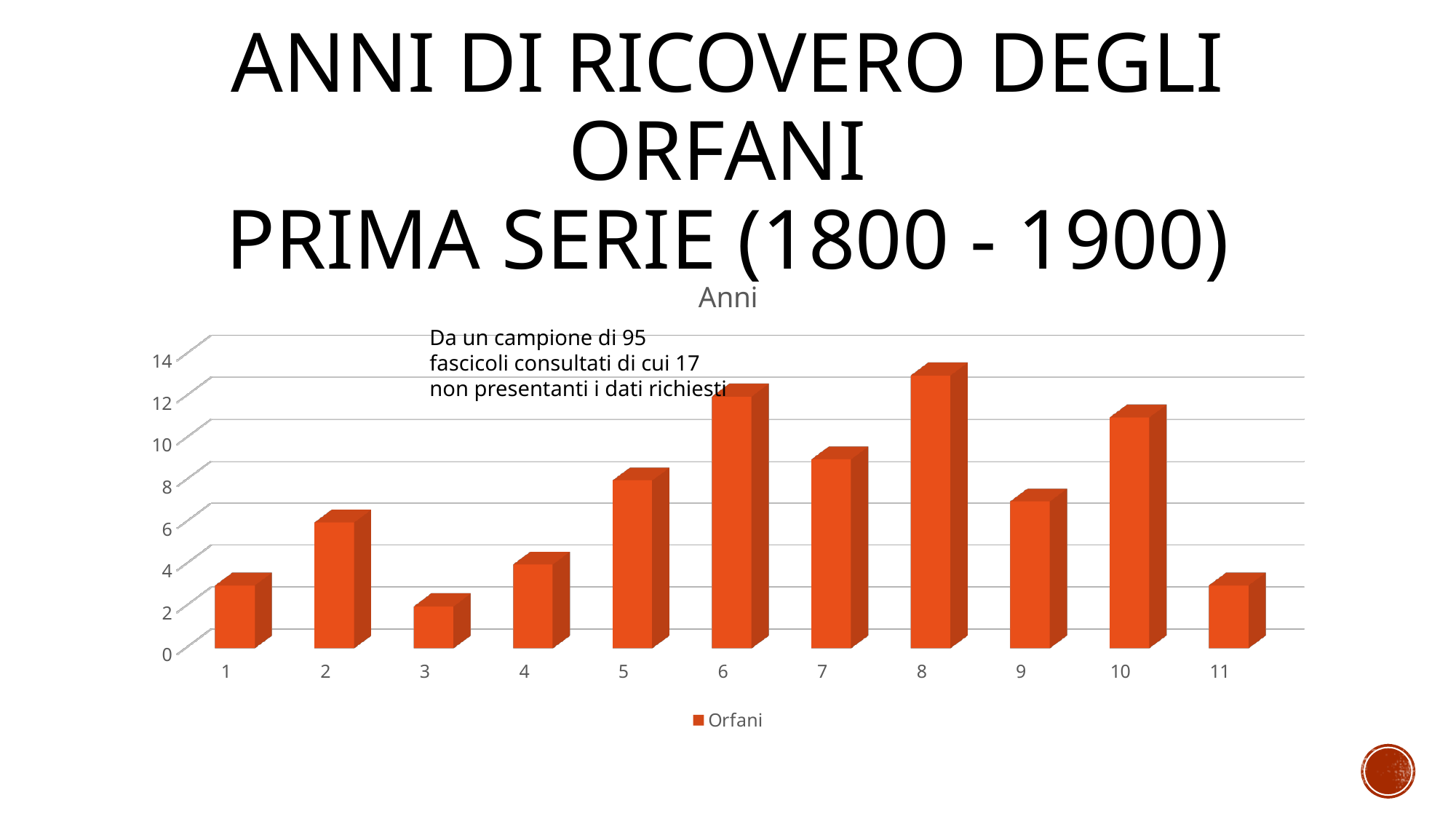
What kind of chart is shown on the slide? bar chart Is the value for category 10 greater or less than 8? greater Is the value for category 3 greater or less than 4? less How many categories are shown on the x axis of the chart? 11 Which has the larger value, category 5 or category 9? 5 Is the value for category 6 greater or less than 10? greater Which category has the shortest bar in the chart? 3 What is the name of the series shown in the chart legend? Orfani How many series does the chart legend list? 1 Which category has the tallest bar in the chart? 8 What is the title of the chart? Anni Which has the larger value, category 2 or category 11? 2